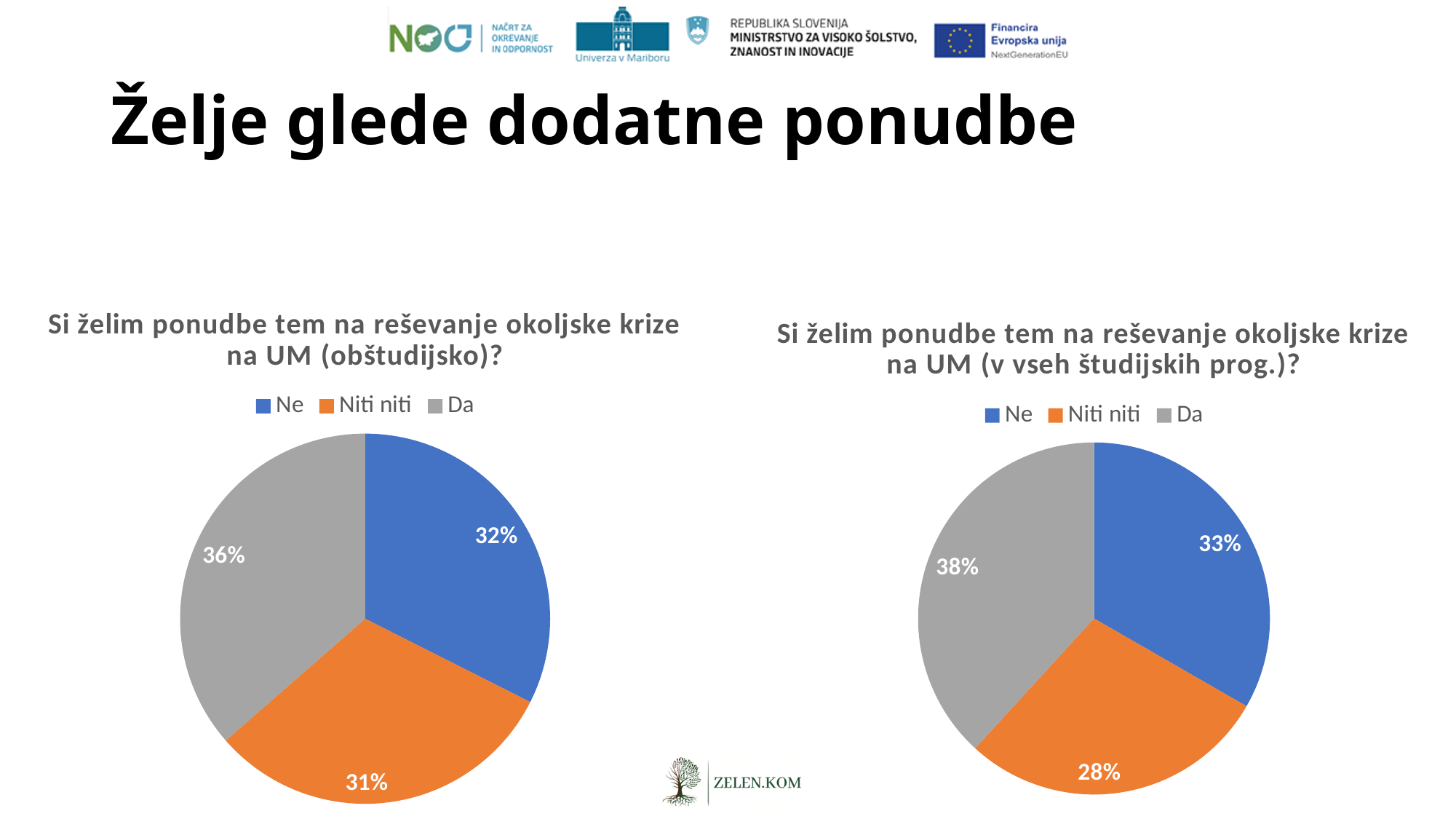
In the left pie chart (obštudijsko), which colour represents 'Niti niti'? Orange In the left pie chart (obštudijsko), what share is labelled for 'Da'? 36% In the left pie chart (obštudijsko), what is the difference in percentage points between 'Da' and 'Ne'? 4 What type of chart is used on the right side of the slide? Pie chart In the right pie chart (v vseh študijskih prog.), what is the difference in percentage points between 'Da' and 'Niti niti'? 10 In the right pie chart (v vseh študijskih prog.), what share is labelled for 'Da'? 38% In the right pie chart (v vseh študijskih prog.), which category has the smallest slice? Niti niti In the right pie chart (v vseh študijskih prog.), which category has the largest slice? Da In the left pie chart (obštudijsko), which category has the largest slice? Da In the left pie chart (obštudijsko), what share is labelled for 'Ne'? 32% How many categories does the legend of the left pie chart (obštudijsko) list? 3 In the right pie chart (v vseh študijskih prog.), what share is labelled for 'Niti niti'? 28%